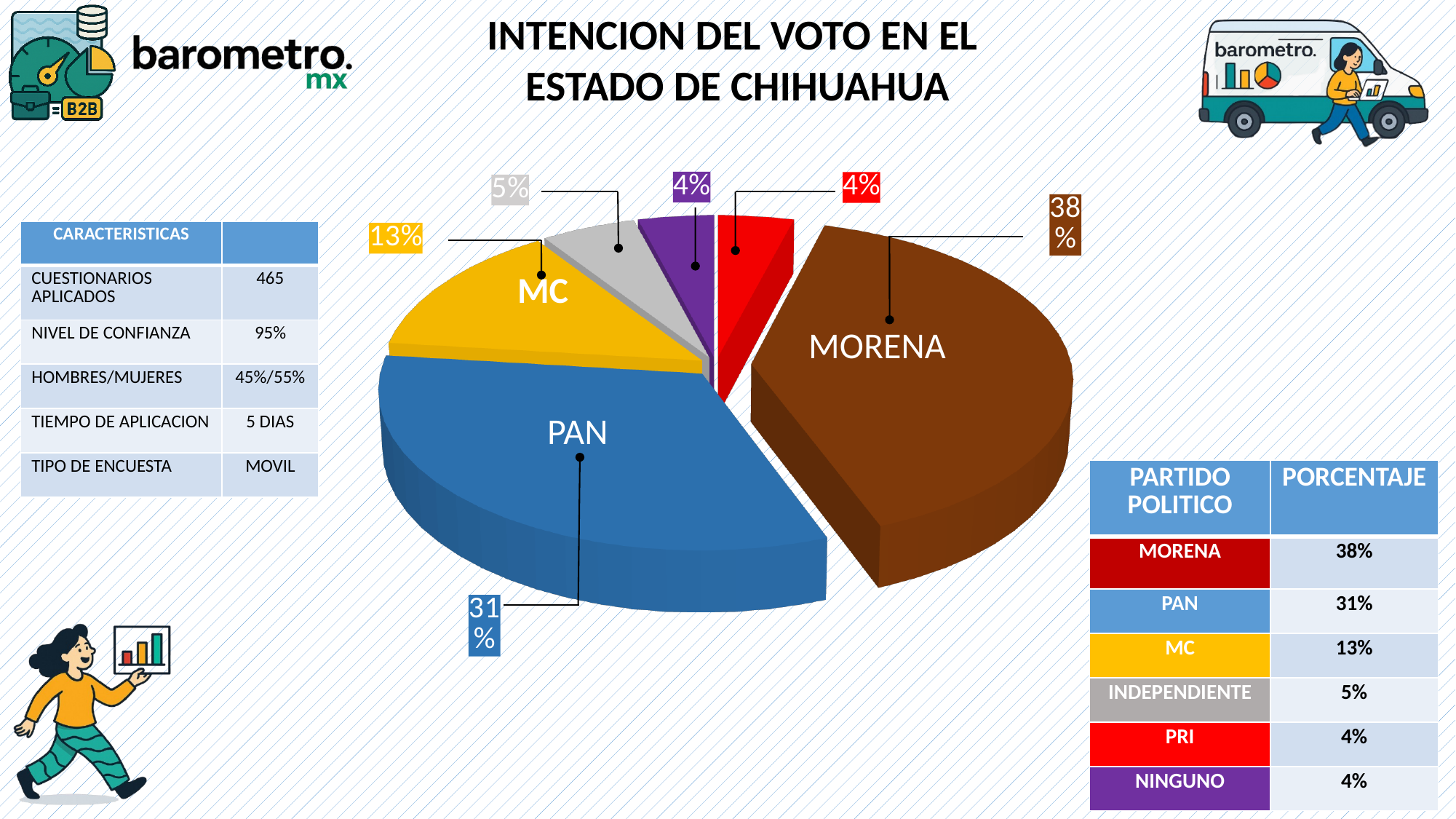
What percentage of the pie does MC hold? 13% Which party has the largest slice of the pie? MORENA What is the combined share of MORENA and PAN? 69% How many slices does the pie chart have? 6 What percentage of the pie does MORENA hold? 38% What is the difference in percentage points between MORENA and PAN? 7 What percentage is shown for the gray slice (INDEPENDIENTE)? 5% What percentage of the pie does PAN hold? 31% What colour is the MORENA slice? brown What kind of chart is shown on the slide? pie chart What is the title of the chart? INTENCION DEL VOTO EN EL ESTADO DE CHIHUAHUA Which is larger, the slice for PAN or the slice for MC? PAN